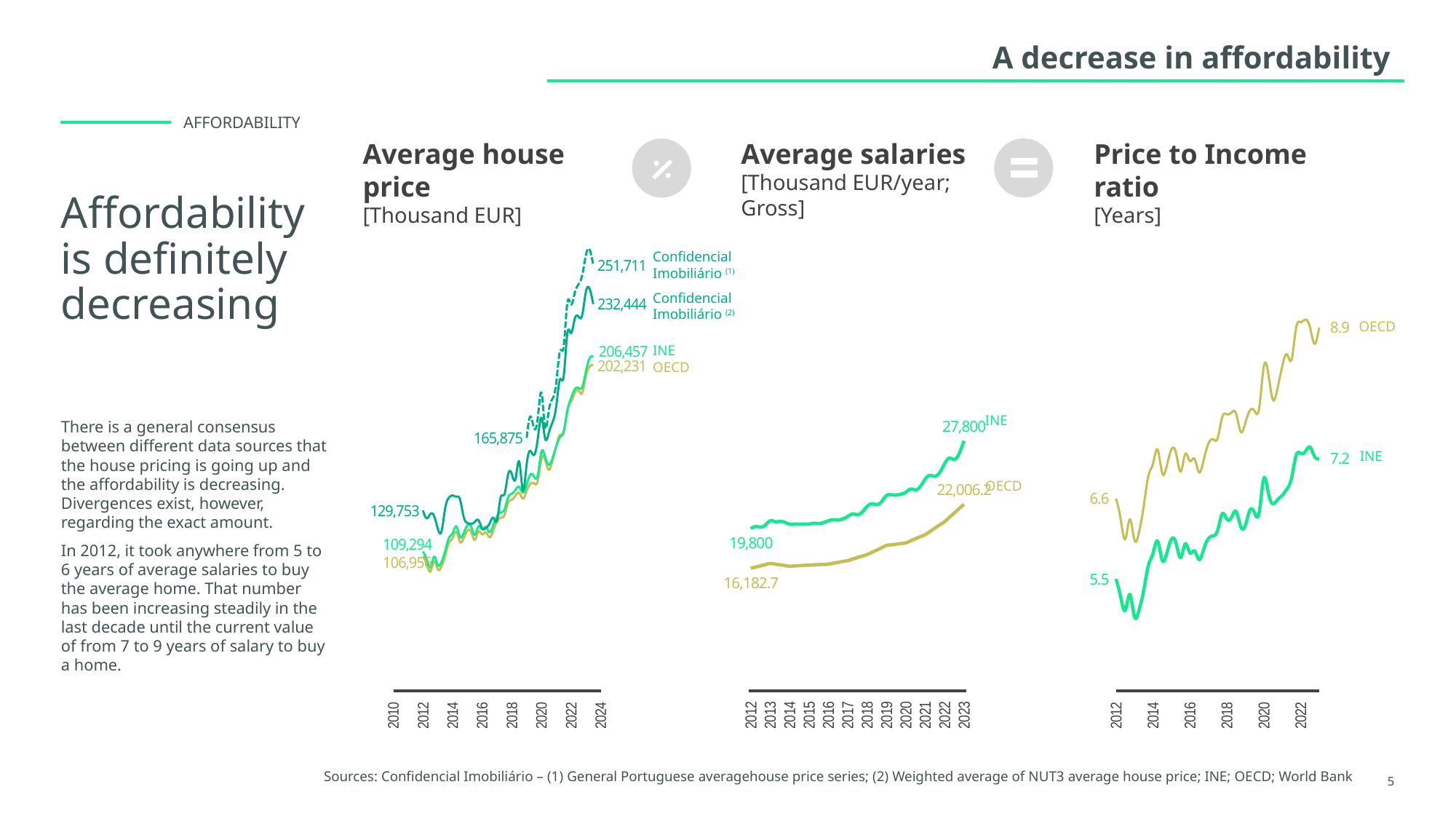
What kind of chart is the 'Average house price' chart? Line chart How many series are plotted in the 'Price to Income ratio' chart? 2 In the 'Price to Income ratio' chart, what is the difference between the latest OECD value (8.9) and the latest INE value (7.2)? 1.7 In the 'Average salaries' chart, what is the latest value labelled for the INE series? 27,800 In the 'Average salaries' chart, what is the starting value labelled for the OECD series? 16,182.7 In the 'Average house price' chart, which series has the highest latest value? Confidencial Imobiliário (1) In the 'Average house price' chart, what is the latest value labelled for the Confidencial Imobiliário (1) series? 251,711 In the 'Price to Income ratio' chart, what is the latest value labelled for the OECD series? 8.9 In the 'Price to Income ratio' chart, do the values generally rise or fall from 2012 to the end of the series? Rise In the 'Average house price' chart, what is the difference between the latest Confidencial Imobiliário (1) value (251,711) and the latest Confidencial Imobiliário (2) value (232,444)? 19,267 In the 'Average house price' chart, what is the latest value labelled for the INE series? 206,457 In the 'Average salaries' chart, which series has the higher latest value, INE or OECD? INE